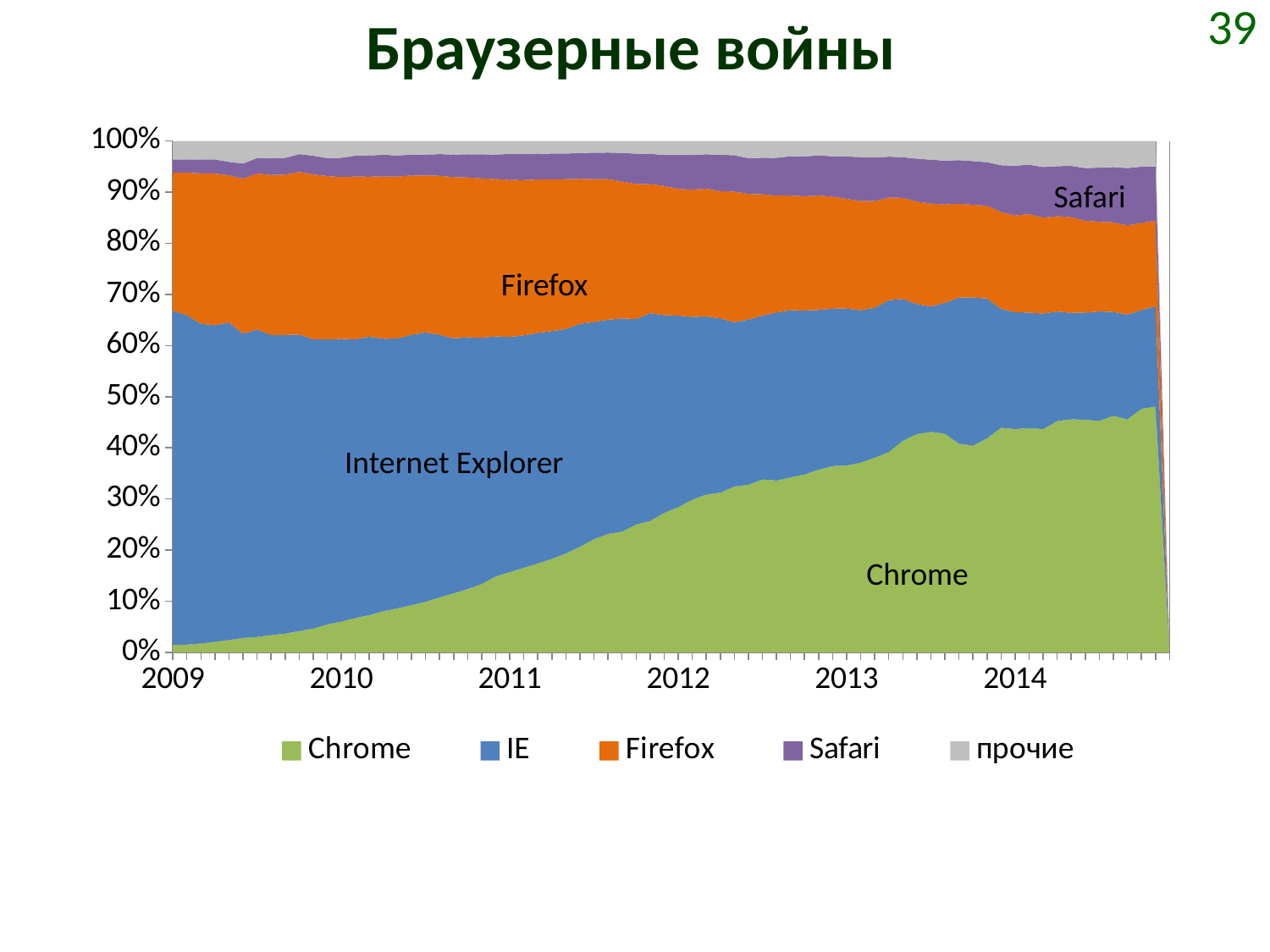
How many year labels are shown on the x axis? 6 What kind of chart is shown on the slide? stacked area chart Does the share of Internet Explorer rise or fall from 2009 to 2014? fall At the start of 2014, which has the larger share: Chrome or Internet Explorer? Chrome Is the share of Chrome at the start of 2009 greater or less than 10%? less What is the title of the chart? Браузерные войны Does the share of Chrome rise or fall from 2009 to 2014? rise How many series does the legend list? 5 Which series has the largest share at the start of 2009? Internet Explorer At the start of 2009, which has the larger share: Internet Explorer or Chrome? Internet Explorer Which series is shown in green in the chart? Chrome Is the share of Chrome at the start of 2014 greater or less than 40%? greater